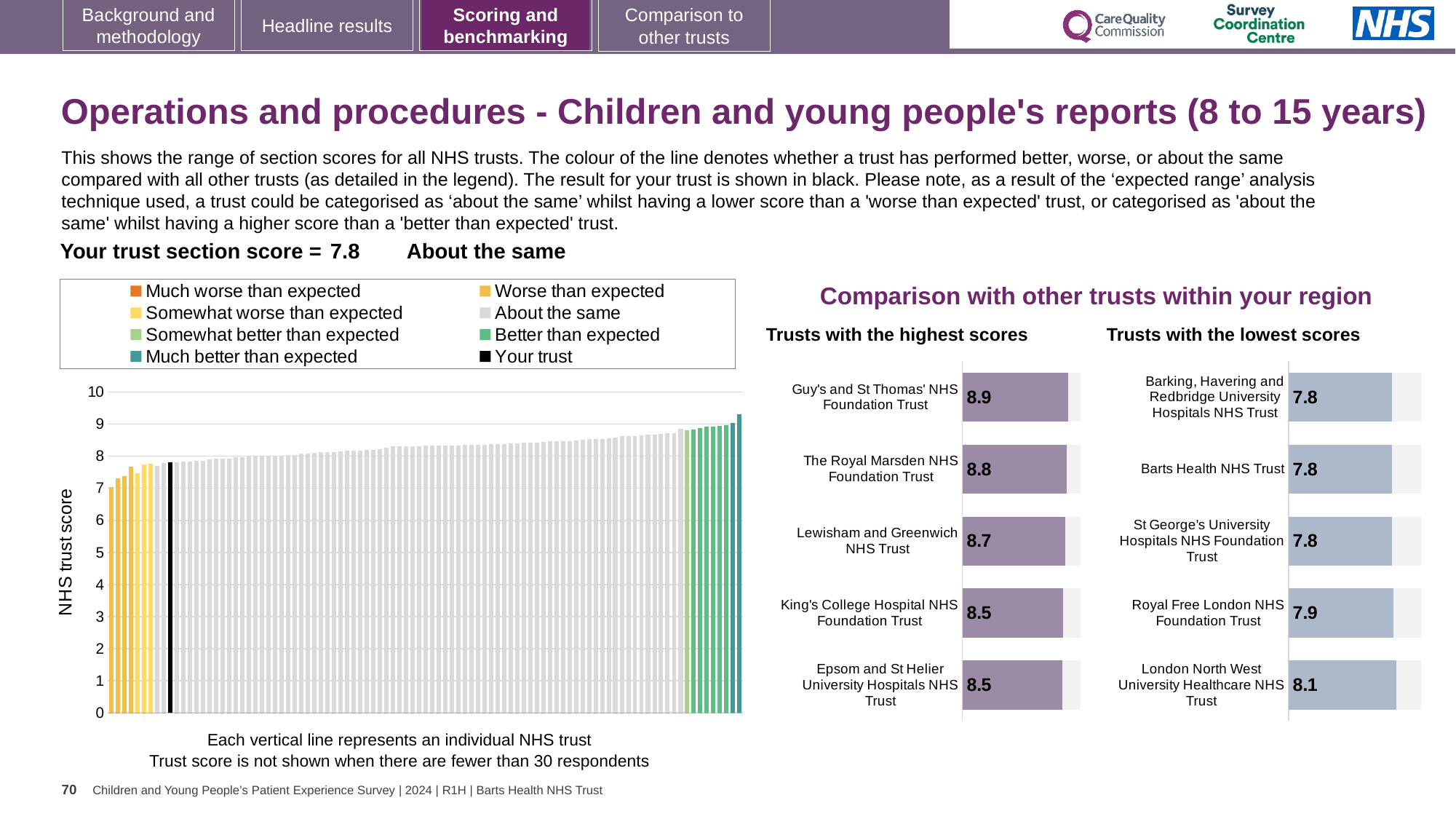
In the 'Trusts with the lowest scores' chart, which trust has the highest score? London North West University Healthcare NHS Trust In the 'Trusts with the highest scores' chart, which trust has the highest score? Guy's and St Thomas' NHS Foundation Trust How many trusts are shown in the 'Trusts with the highest scores' chart? 5 What kind of chart is the 'NHS trust score' chart on the left of the slide? Bar chart In the 'Trusts with the lowest scores' chart, what is the score for Royal Free London NHS Foundation Trust? 7.9 How many entries does the legend above the 'NHS trust score' chart list? 8 In the 'Trusts with the highest scores' chart, what is the difference between the scores of Guy's and St Thomas' NHS Foundation Trust and Epsom and St Helier University Hospitals NHS Trust? 0.4 In the 'Trusts with the highest scores' chart, which has the larger score: The Royal Marsden NHS Foundation Trust or King's College Hospital NHS Foundation Trust? The Royal Marsden NHS Foundation Trust In the 'Trusts with the highest scores' chart, what is the score for Guy's and St Thomas' NHS Foundation Trust? 8.9 In the 'NHS trust score' chart on the left, do the bar values rise or fall from left to right? Rise In the 'Trusts with the lowest scores' chart, what is the score for London North West University Healthcare NHS Trust? 8.1 In the 'NHS trust score' chart on the left, what is the section score for your trust (the black bar)? 7.8